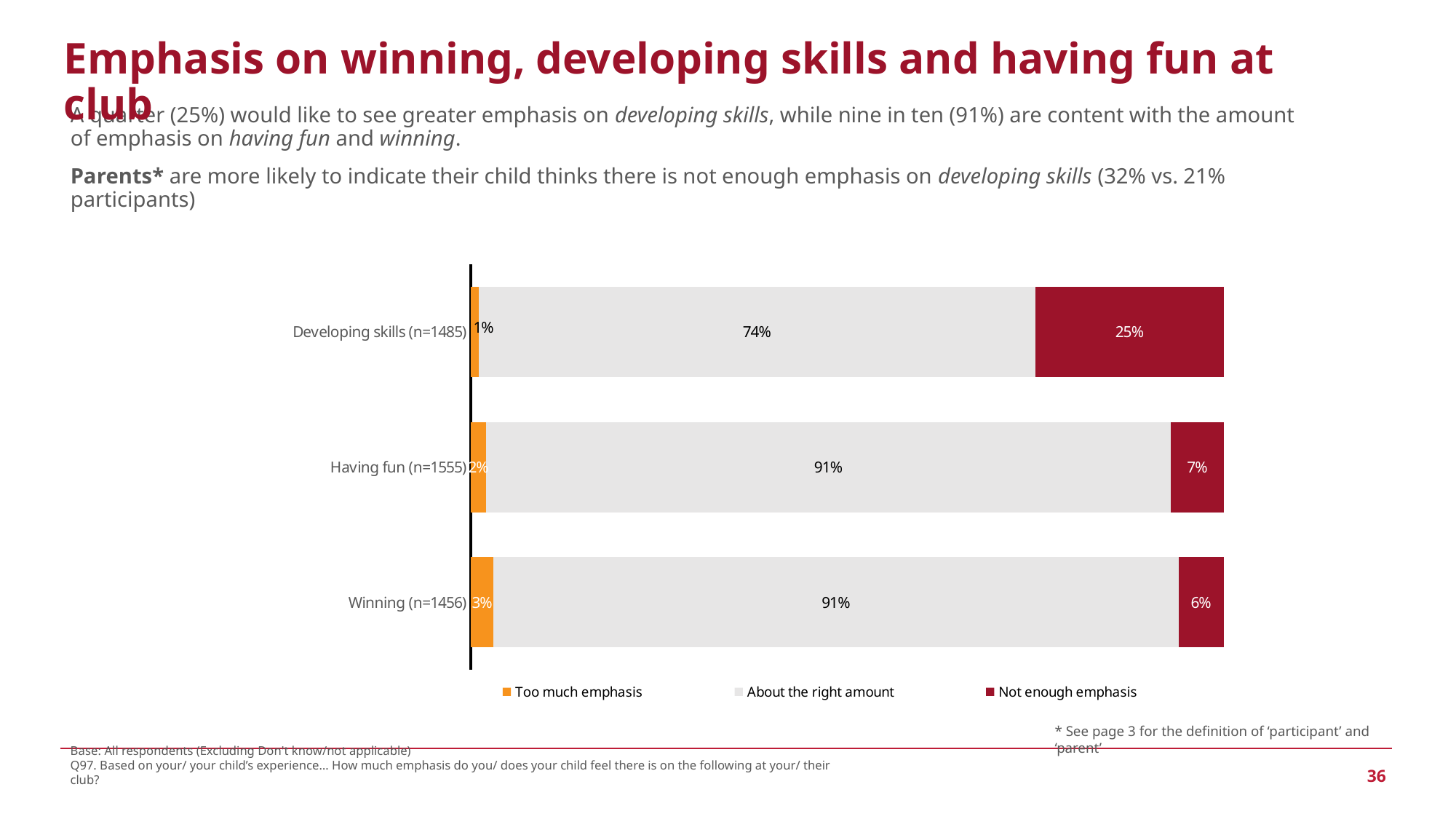
Which category has the lowest share of 'Too much emphasis' responses? Developing skills (n=1485) How many series does the legend list? 3 What percentage said there is too much emphasis on winning? 3% How many categories are shown in the chart? 3 What percentage of respondents said there is not enough emphasis on developing skills? 25% Is the 'Not enough emphasis' share larger for having fun or for winning? Having fun What type of chart is shown on the slide? Stacked bar chart What percentage said there is about the right amount of emphasis on having fun? 91% What percentage said there is about the right amount of emphasis on developing skills? 74% What is the difference between the 'Not enough emphasis' percentages for developing skills and having fun? 18 percentage points Which colour represents 'Not enough emphasis' in the chart? Dark red Which category has the highest share of 'Not enough emphasis' responses? Developing skills (n=1485)